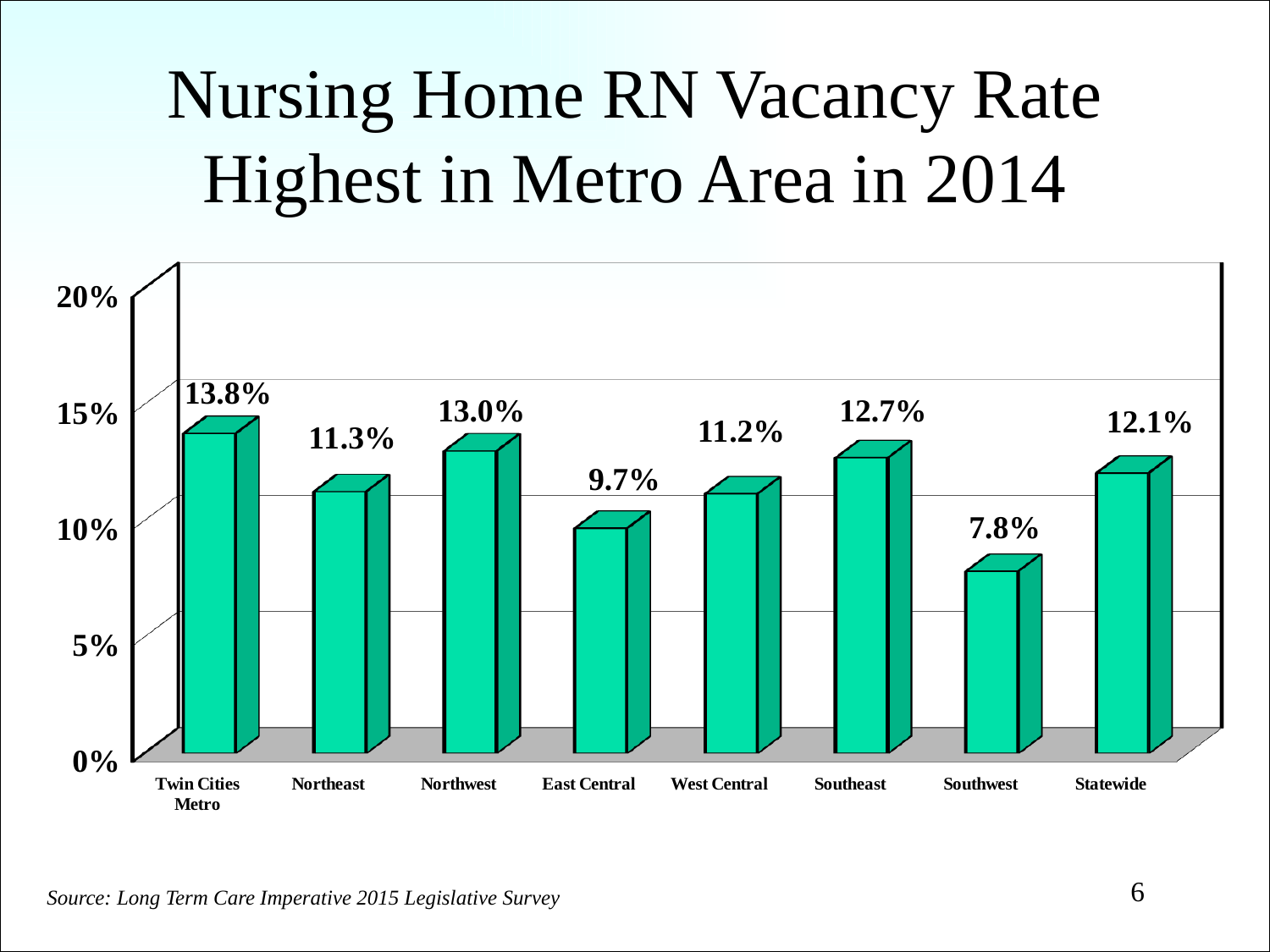
Which region has the highest RN vacancy rate? Twin Cities Metro Which has a higher vacancy rate, Northwest or Southeast? Northwest Is the vacancy rate for East Central greater or less than 10%? less How many categories are shown on the x axis? 8 What is the difference between the Northeast and West Central vacancy rates? 0.1% What is the difference between the Twin Cities Metro and Southwest vacancy rates? 6.0% What is the RN vacancy rate for Twin Cities Metro? 13.8% What kind of chart is shown on the slide? bar chart What is the RN vacancy rate for Southwest? 7.8% What is the Statewide RN vacancy rate? 12.1% What is the title of the chart on the slide? Nursing Home RN Vacancy Rate Highest in Metro Area in 2014 Which region has the lowest RN vacancy rate? Southwest